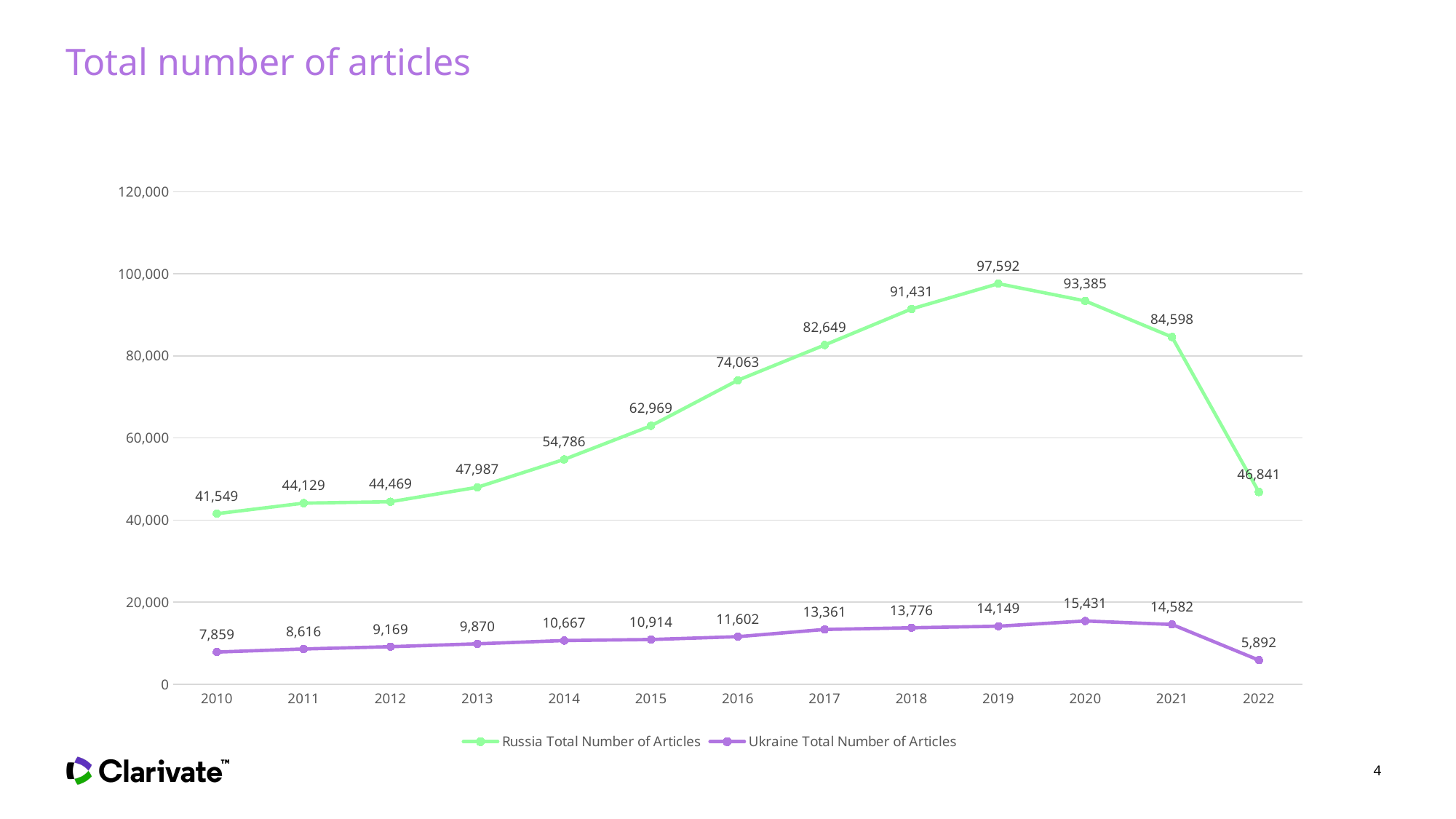
What is the Russia Total Number of Articles value for 2019? 97,592 What is the title of the slide? Total number of articles What is the Ukraine Total Number of Articles value for 2022? 5,892 What kind of chart is shown on the slide? Line chart Which is larger: the Ukraine Total Number of Articles value for 2020 or for 2021? 2020 How many series does the legend list? 2 In which year does the Russia Total Number of Articles series reach its highest value? 2019 Is the Russia Total Number of Articles value for 2018 greater or less than 80,000? greater How many years are shown on the x axis? 13 What is the difference between the Russia Total Number of Articles values for 2021 and 2022? 37,757 In which year does the Ukraine Total Number of Articles series have its lowest value? 2022 Does the Ukraine Total Number of Articles series rise or fall from 2010 to 2020? Rise